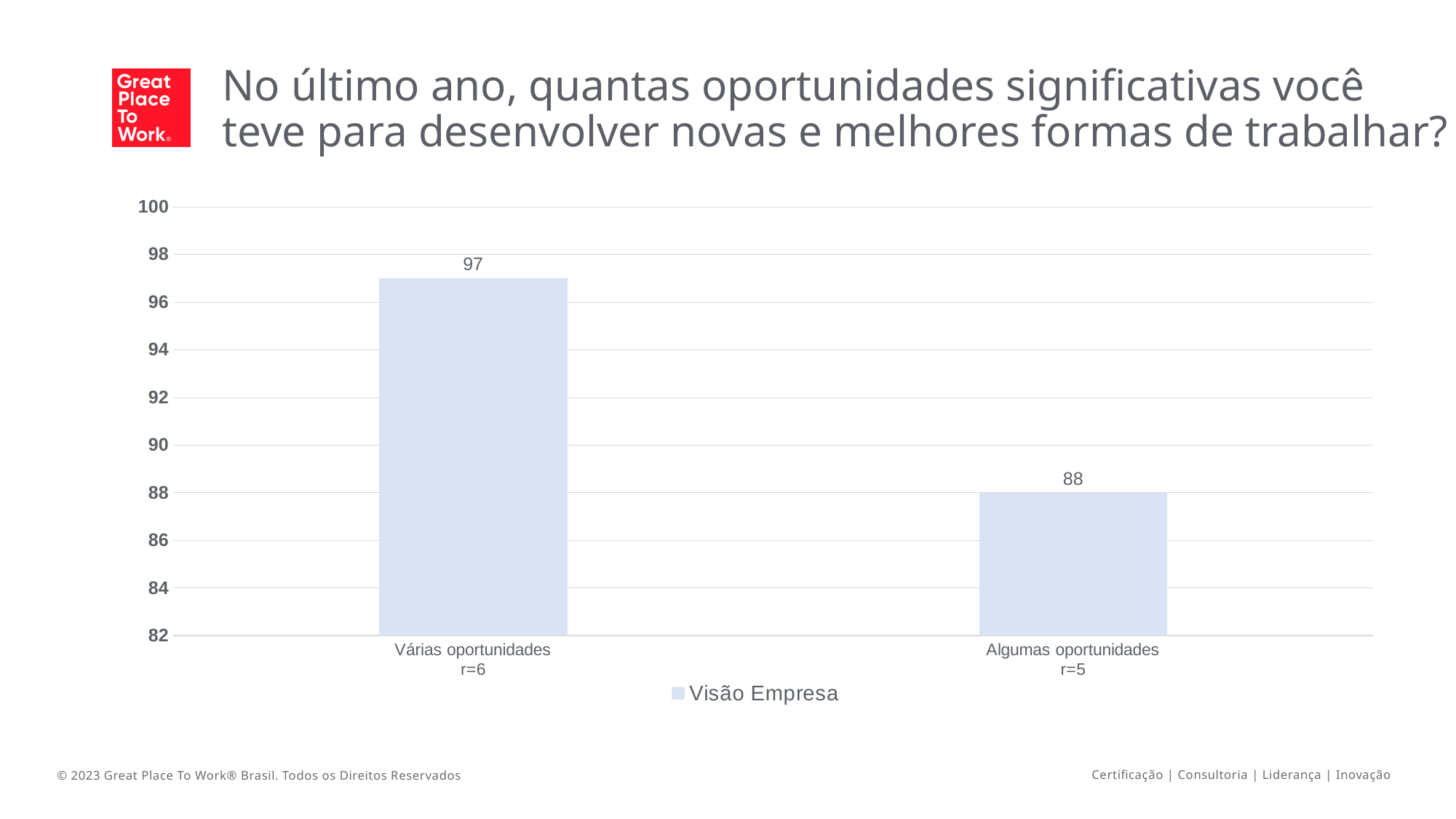
Which is larger, the value for "Várias oportunidades" or for "Algumas oportunidades"? Várias oportunidades How many series does the legend list? 1 What is the value for "Algumas oportunidades"? 88 Which category has the lowest value? Algumas oportunidades What is the difference between the values for "Várias oportunidades" and "Algumas oportunidades"? 9 How many categories are shown on the x axis? 2 What is the name of the series shown in the legend? Visão Empresa What kind of chart is shown on the slide? bar chart Do the values rise or fall from left to right along the x axis? fall What is the value for "Várias oportunidades"? 97 Which category has the highest value? Várias oportunidades Is the value for "Algumas oportunidades" greater or less than 90? less